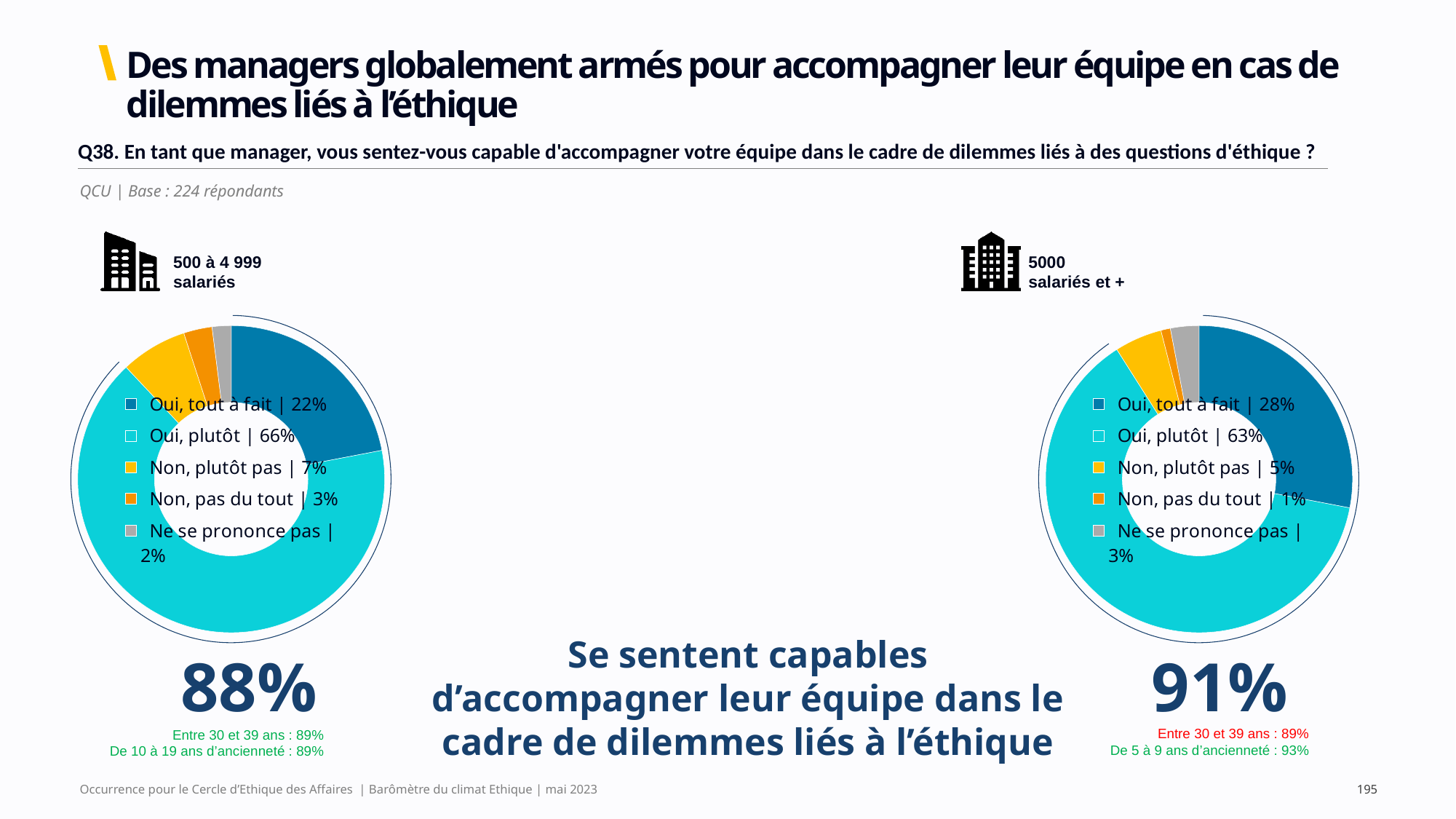
What type of chart is used for '5000 salariés et +'? Donut (pie) chart Is 'Oui, tout à fait' higher in the chart for '500 à 4 999 salariés' or in the chart for '5000 salariés et +'? 5000 salariés et + In the chart for '5000 salariés et +', which category has the smallest share? Non, pas du tout In the chart for '500 à 4 999 salariés', what is the value for 'Oui, plutôt'? 66% In the chart for '5000 salariés et +', what is the value for 'Ne se prononce pas'? 3% In the chart for '500 à 4 999 salariés', which category has the largest share? Oui, plutôt Which is larger in the chart for '5000 salariés et +': 'Non, plutôt pas' or 'Ne se prononce pas'? Non, plutôt pas In the chart for '5000 salariés et +', what is the value for 'Oui, tout à fait'? 28% In the chart for '500 à 4 999 salariés', what is the value for 'Non, pas du tout'? 3% What colour represents 'Non, plutôt pas' in the chart for '500 à 4 999 salariés'? Yellow How many categories does the legend of the chart for '500 à 4 999 salariés' list? 5 What is the difference between 'Oui, plutôt' and 'Oui, tout à fait' in the chart for '500 à 4 999 salariés'? 44%